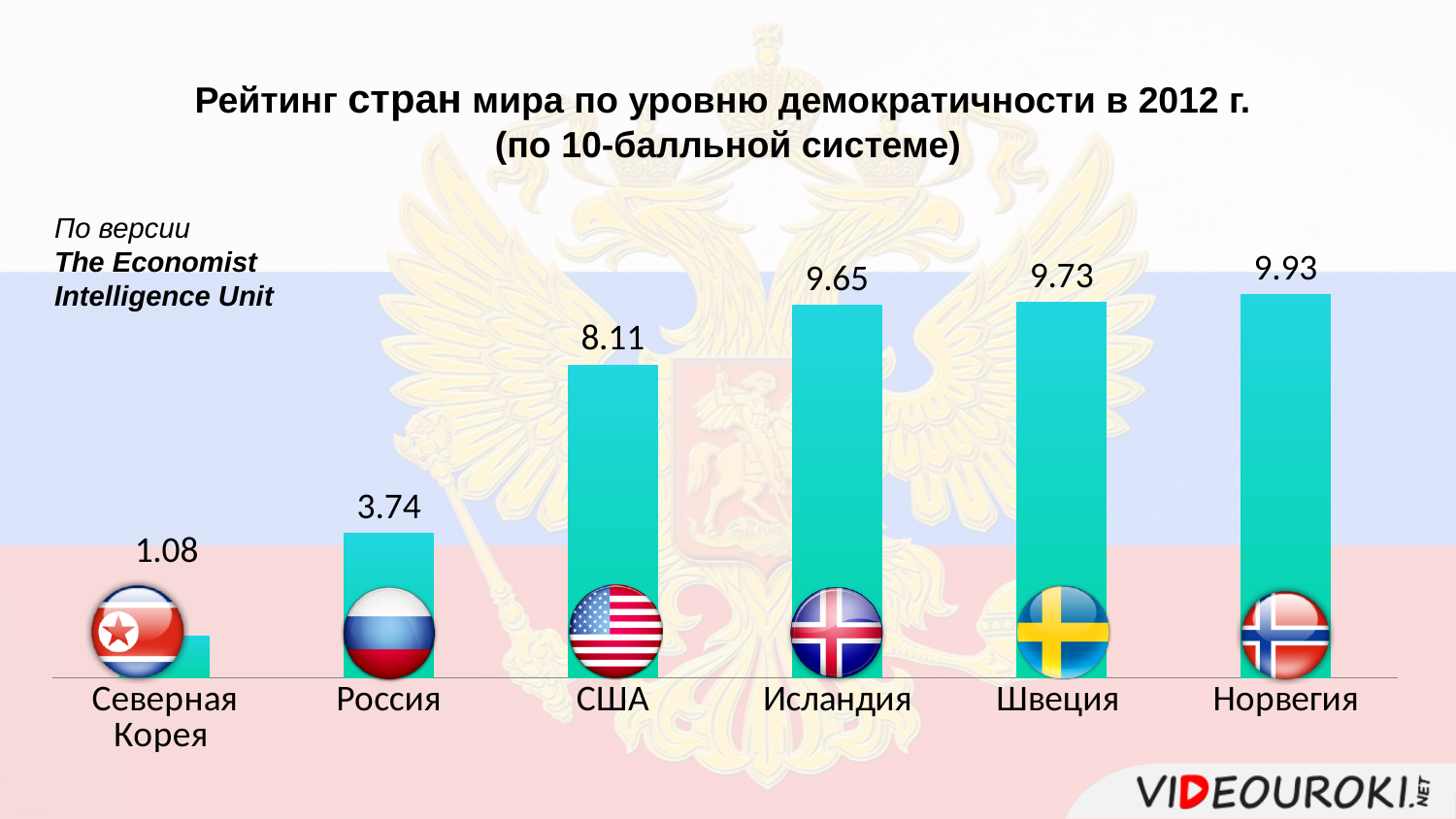
What is the democracy rating for Северная Корея? 1.08 What is the democracy rating for США? 8.11 What is the democracy rating for Россия? 3.74 What is the democracy rating for Исландия? 9.65 Which country has the highest democracy rating on the chart? Норвегия How many countries are shown on the chart? 6 Do the values rise or fall from left to right along the x axis? Rise What is the difference between the ratings of Норвегия and Швеция? 0.2 What is the difference between the ratings of США and Россия? 4.37 Which country has the lowest democracy rating on the chart? Северная Корея Which has a higher rating, Швеция or Исландия? Швеция What kind of chart is shown on the slide? Bar chart